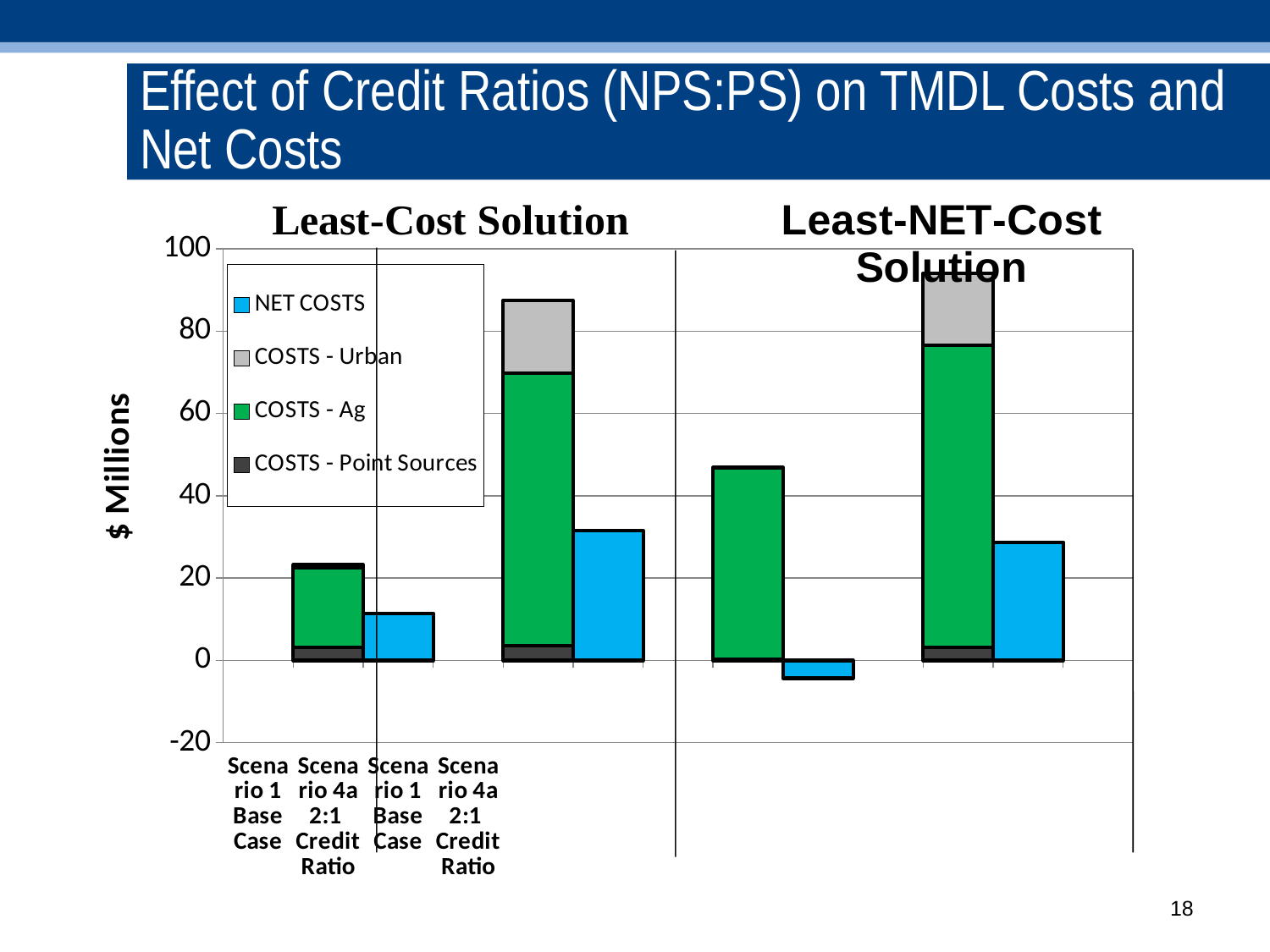
How many stacked cost bars are plotted across both sections of the chart? 4 In the Least-Cost Solution section, is the total of the Scenario 4a 2:1 Credit Ratio stacked cost bar greater or less than 80? greater In the Least-NET-Cost Solution section, is the NET COSTS value for the second scenario (Scenario 4a 2:1 Credit Ratio) greater or less than 20? greater How many series does the legend list? 4 In the Least-Cost Solution section, is the NET COSTS value for Scenario 1 Base Case greater or less than 20? less What is the title of the vertical axis? $ Millions Which stacked cost bar is the tallest on the chart? Scenario 4a 2:1 Credit Ratio in the Least-NET-Cost Solution What kind of chart is shown on the slide? bar chart What are the four series listed in the legend? NET COSTS, COSTS - Urban, COSTS - Ag, COSTS - Point Sources Which section of the chart contains a NET COSTS bar that goes below zero? Least-NET-Cost Solution